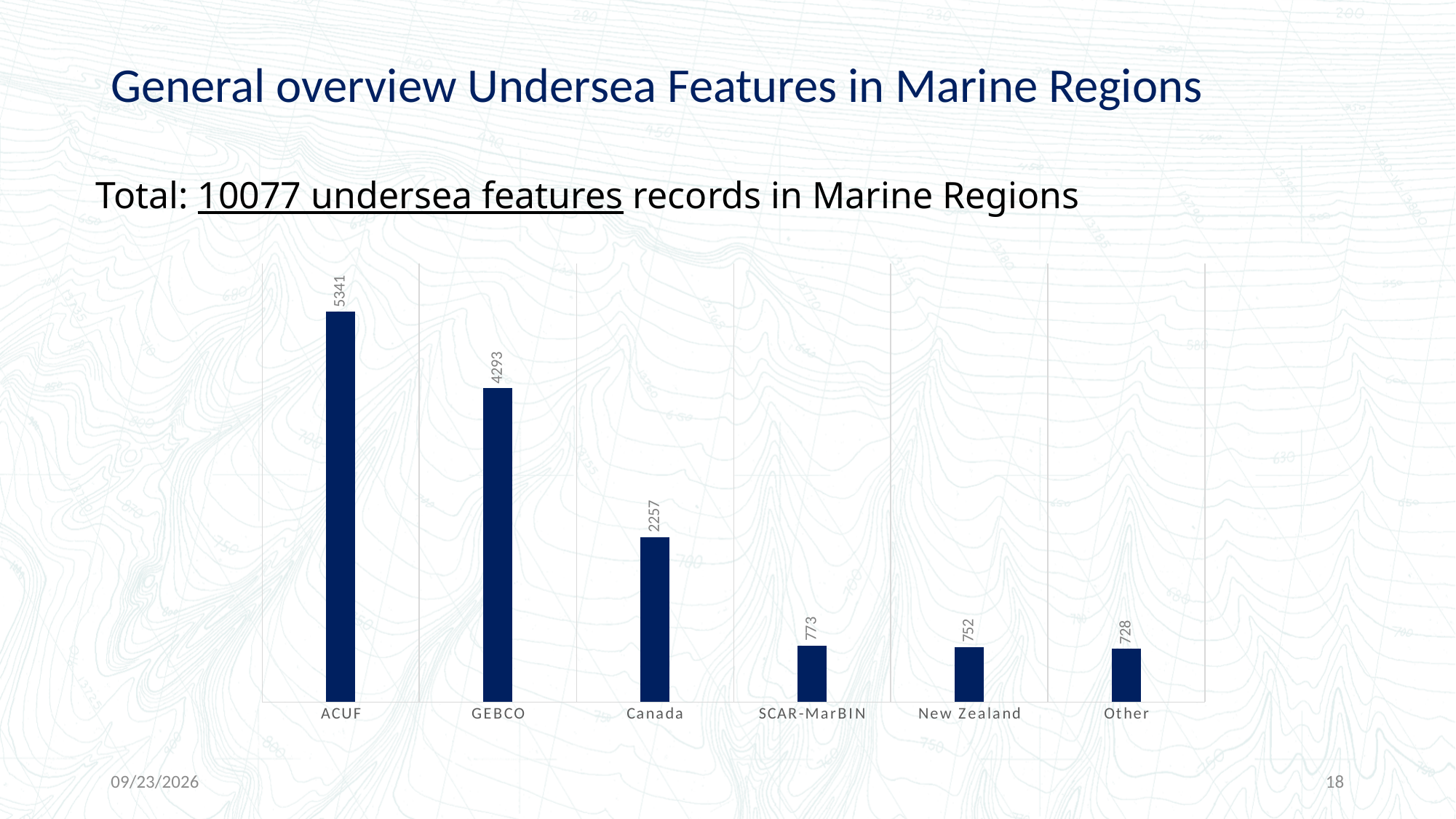
What is the value for ACUF? 5341 What is the value for New Zealand? 752 Do the values rise or fall from left to right along the x axis? Fall How many categories are shown on the x axis? 6 Which category has the lowest value? Other What kind of chart is shown on the slide? Bar chart Which is larger, the value for GEBCO or the value for Canada? GEBCO What is the value for SCAR-MarBIN? 773 What is the value for GEBCO? 4293 What is the difference between the values for ACUF and GEBCO? 1048 What is the value for Canada? 2257 Which category has the highest value? ACUF